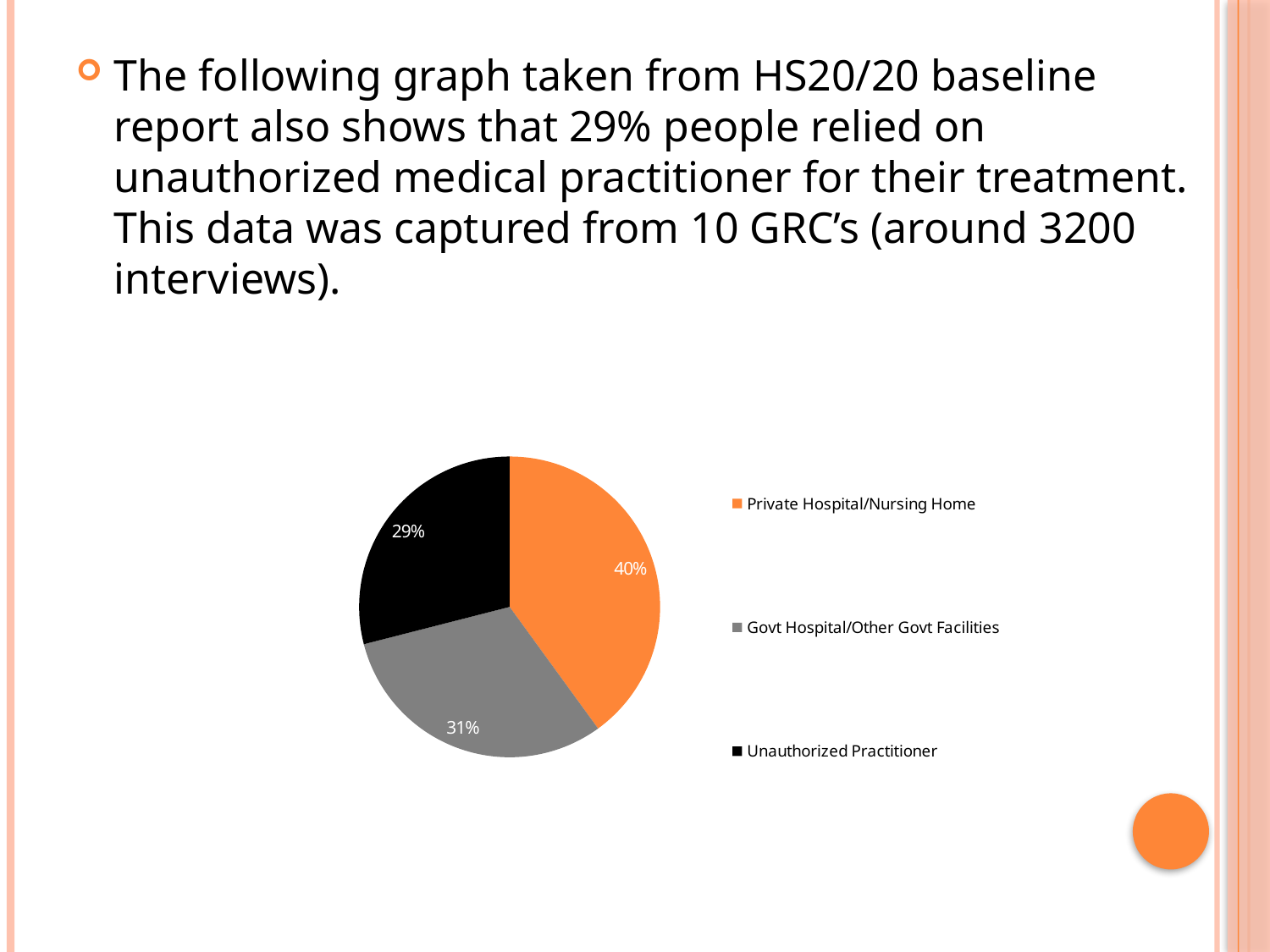
What percentage of the pie is Private Hospital/Nursing Home? 40% Which category has the smallest share of the pie? Unauthorized Practitioner What percentage of the pie is Unauthorized Practitioner? 29% Which category has the largest share of the pie? Private Hospital/Nursing Home What kind of chart is shown on the slide? Pie chart Which is larger: the share for Private Hospital/Nursing Home or the share for Govt Hospital/Other Govt Facilities? Private Hospital/Nursing Home How many entries does the legend list? 3 What is the difference in percentage points between Private Hospital/Nursing Home and Unauthorized Practitioner? 11 What colour is the Unauthorized Practitioner slice? Black What is the difference in percentage points between Govt Hospital/Other Govt Facilities and Unauthorized Practitioner? 2 What percentage of the pie is Govt Hospital/Other Govt Facilities? 31% How many slices does the pie chart have? 3